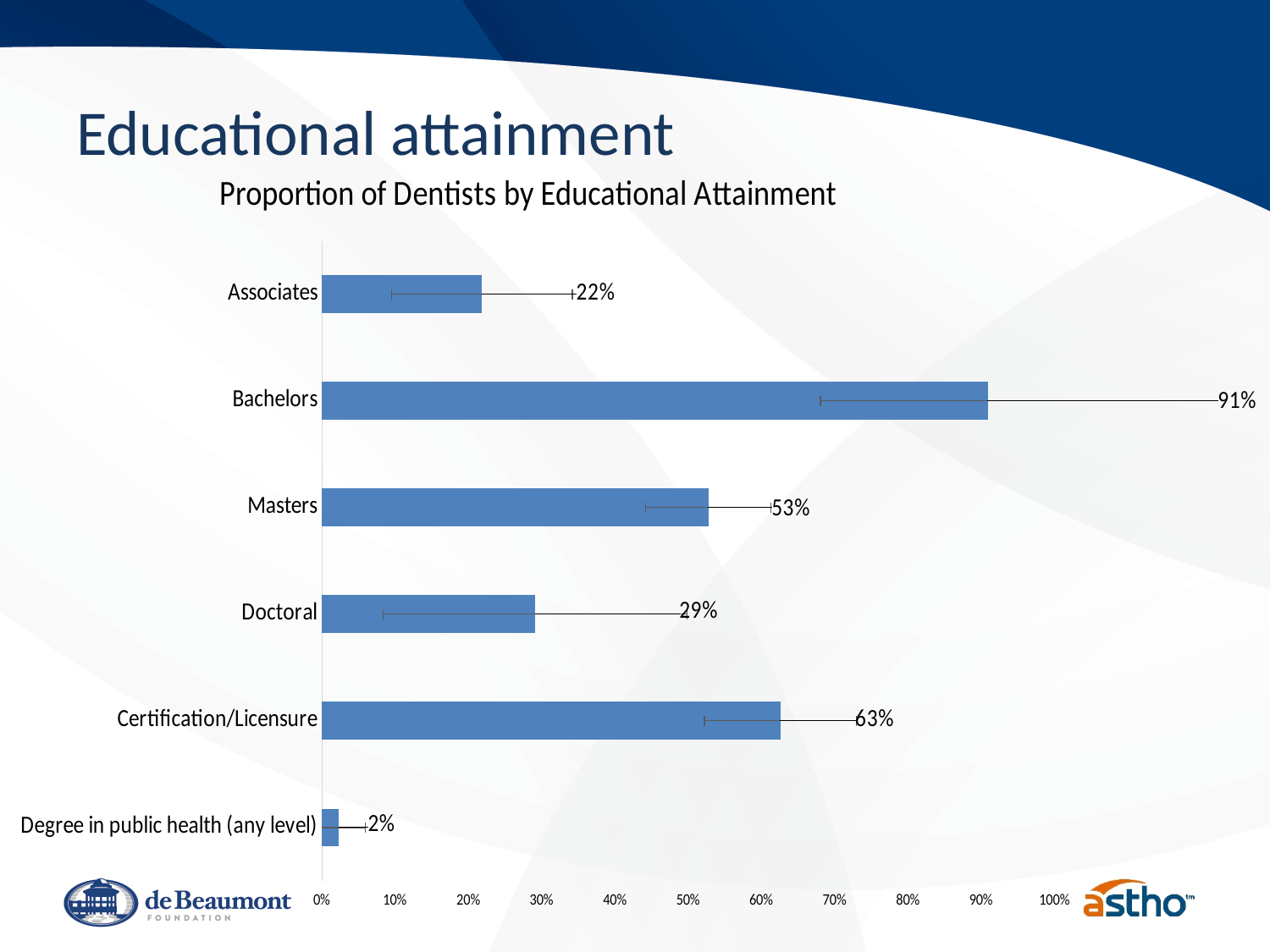
What is the value for Masters? 53% Which is larger, the value for Doctoral or the value for Associates? Doctoral What is the title of the chart? Proportion of Dentists by Educational Attainment How many categories are shown in the chart? 6 What is the value for Bachelors? 91% What is the value for Certification/Licensure? 63% Which category has the lowest value? Degree in public health (any level) Which category has the highest value? Bachelors What kind of chart is shown on the slide? bar chart What is the value for Degree in public health (any level)? 2% Is the value for Certification/Licensure greater or less than 50%? greater What is the difference between the values for Bachelors and Masters? 38%